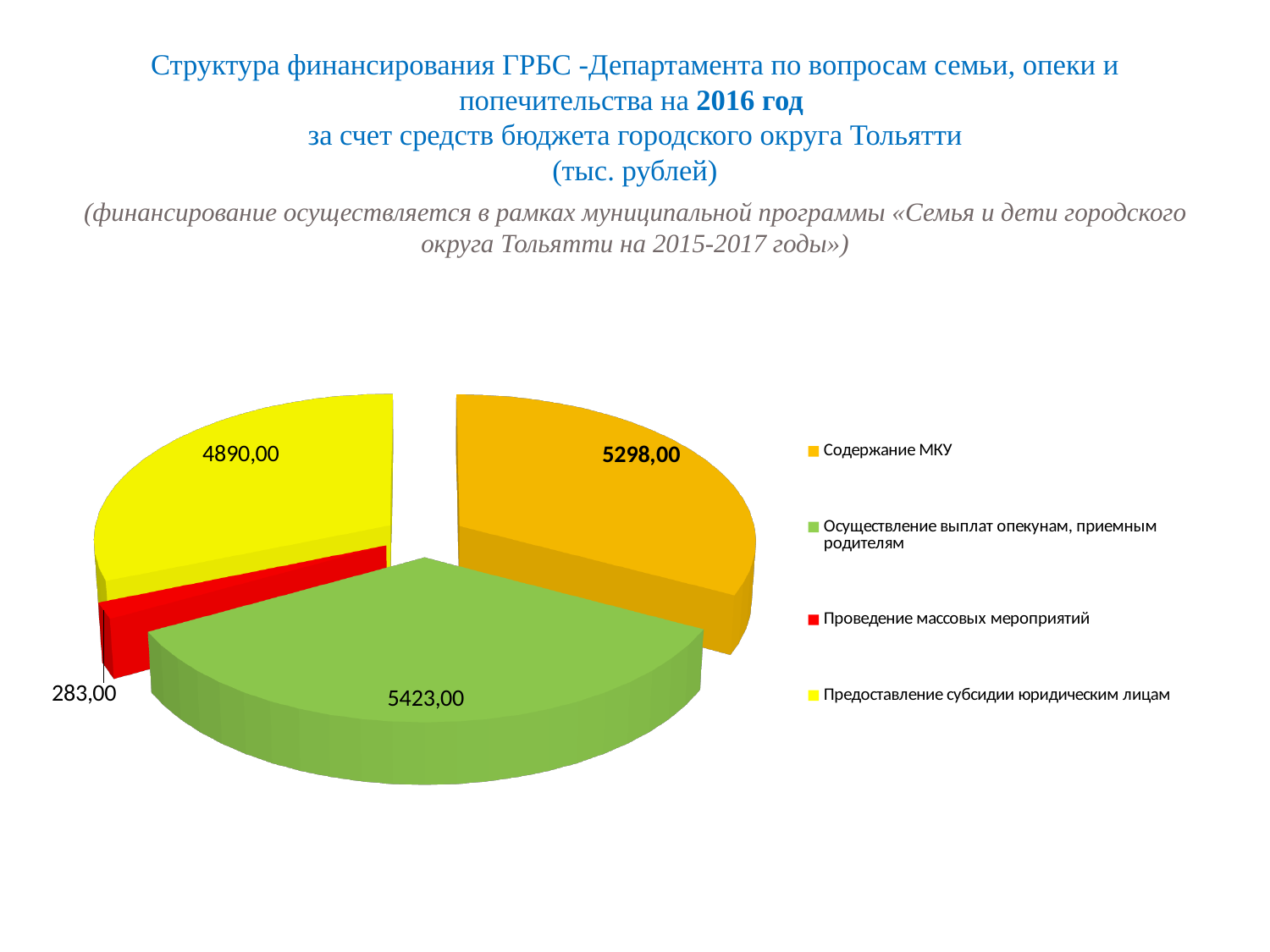
What is the value for Проведение массовых мероприятий? 283,00 How many entries does the legend list? 4 What type of chart is shown on the slide? pie chart What is the value for Предоставление субсидии юридическим лицам? 4890,00 What colour is the slice for Проведение массовых мероприятий? red Which category has the smallest value? Проведение массовых мероприятий What is the value for Содержание МКУ? 5298,00 Which category has the largest value? Осуществление выплат опекунам, приемным родителям What is the difference between the values for Осуществление выплат опекунам, приемным родителям and Содержание МКУ? 125,00 Which is larger: the value for Содержание МКУ or the value for Предоставление субсидии юридическим лицам? Содержание МКУ How many slices does the pie chart have? 4 What is the value for Осуществление выплат опекунам, приемным родителям? 5423,00